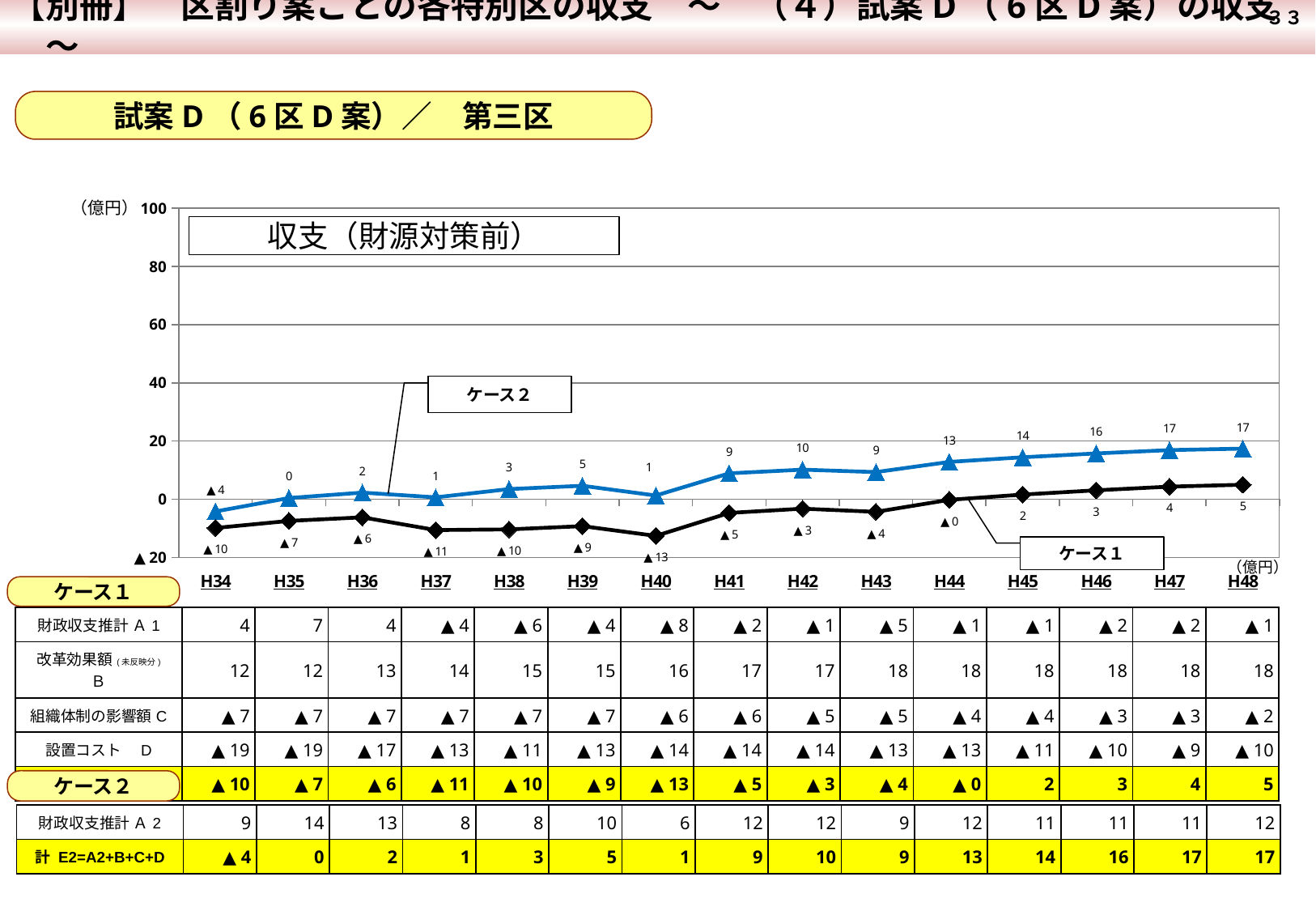
In the chart 収支（財源対策前）, which series has the larger value at H41, ケース1 or ケース2? ケース2 In the chart 収支（財源対策前）, at which year does ケース1 reach its highest value? H48 In the chart 収支（財源対策前）, what is the value of ケース1 at H40? ▲13 In the chart 収支（財源対策前）, what is the difference between ケース2 and ケース1 at H48? 12 How many series are plotted in the chart 収支（財源対策前）? 2 In the chart 収支（財源対策前）, what is the value of ケース2 at H48? 17 In the chart 収支（財源対策前）, at which year is ケース1 at its lowest value? H40 How many years are plotted along the x axis of the chart 収支（財源対策前）? 15 What kind of chart is 収支（財源対策前）? line chart In the chart 収支（財源対策前）, does ケース2 generally rise or fall from H41 to H48? rise In the chart 収支（財源対策前）, at which year is ケース2 at its lowest value? H34 In the chart 収支（財源対策前）, what is the value of ケース2 at H44? 13